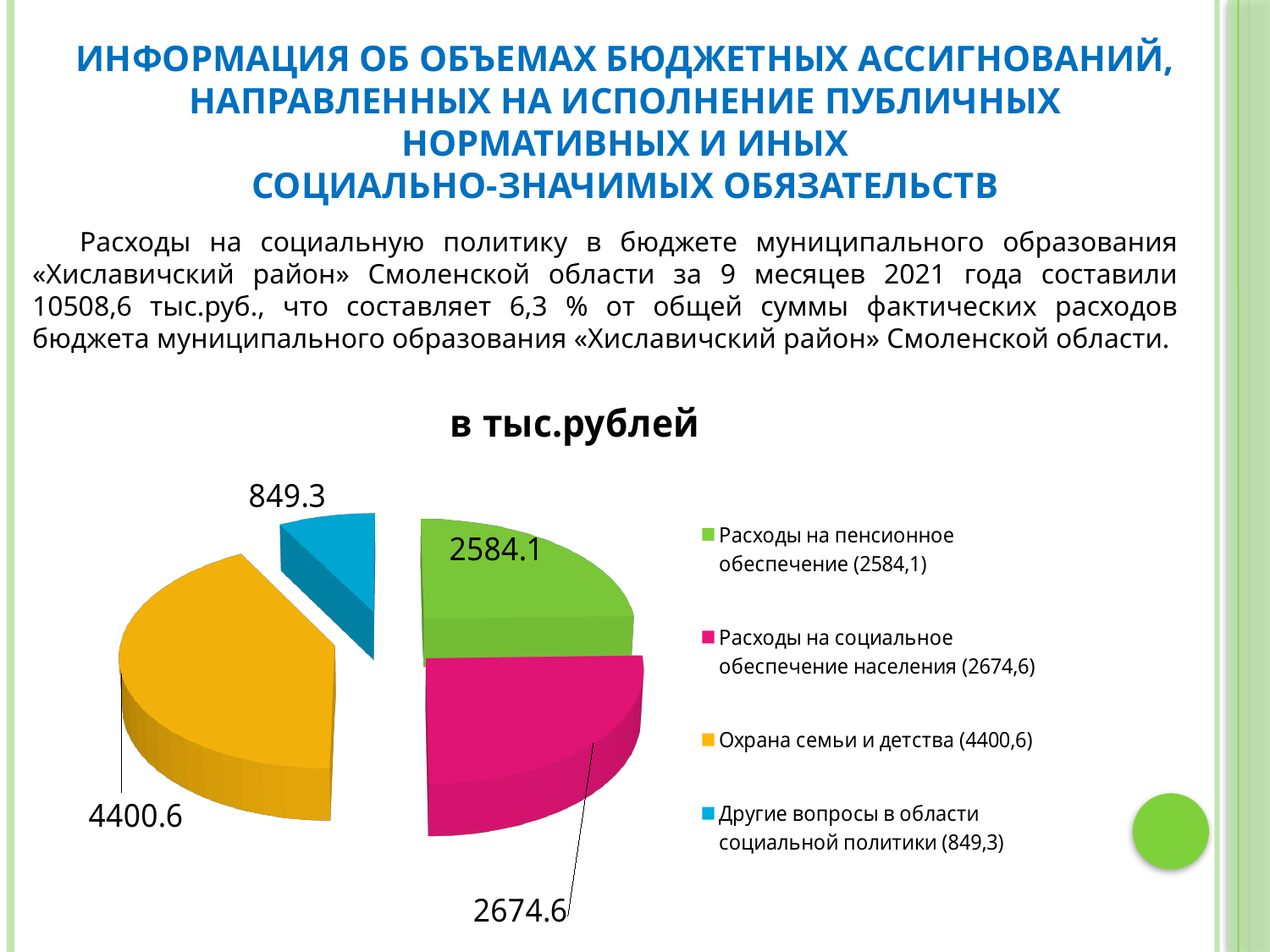
Which is larger: «Расходы на социальное обеспечение населения» or «Расходы на пенсионное обеспечение»? Расходы на социальное обеспечение населения What colour is the slice for «Охрана семьи и детства»? yellow What is the value for «Расходы на социальное обеспечение населения» in the pie chart? 2674.6 Which category has the smallest slice in the pie chart? Другие вопросы в области социальной политики What is the difference between the values for «Охрана семьи и детства» and «Другие вопросы в области социальной политики»? 3551.3 What is the value for «Охрана семьи и детства» in the pie chart? 4400.6 What is the title of the pie chart? в тыс.рублей What kind of chart is shown on the slide? pie chart What is the value for «Расходы на пенсионное обеспечение» in the pie chart? 2584.1 What is the value for «Другие вопросы в области социальной политики» in the pie chart? 849.3 How many slices does the pie chart have? 4 Which category has the largest slice in the pie chart? Охрана семьи и детства